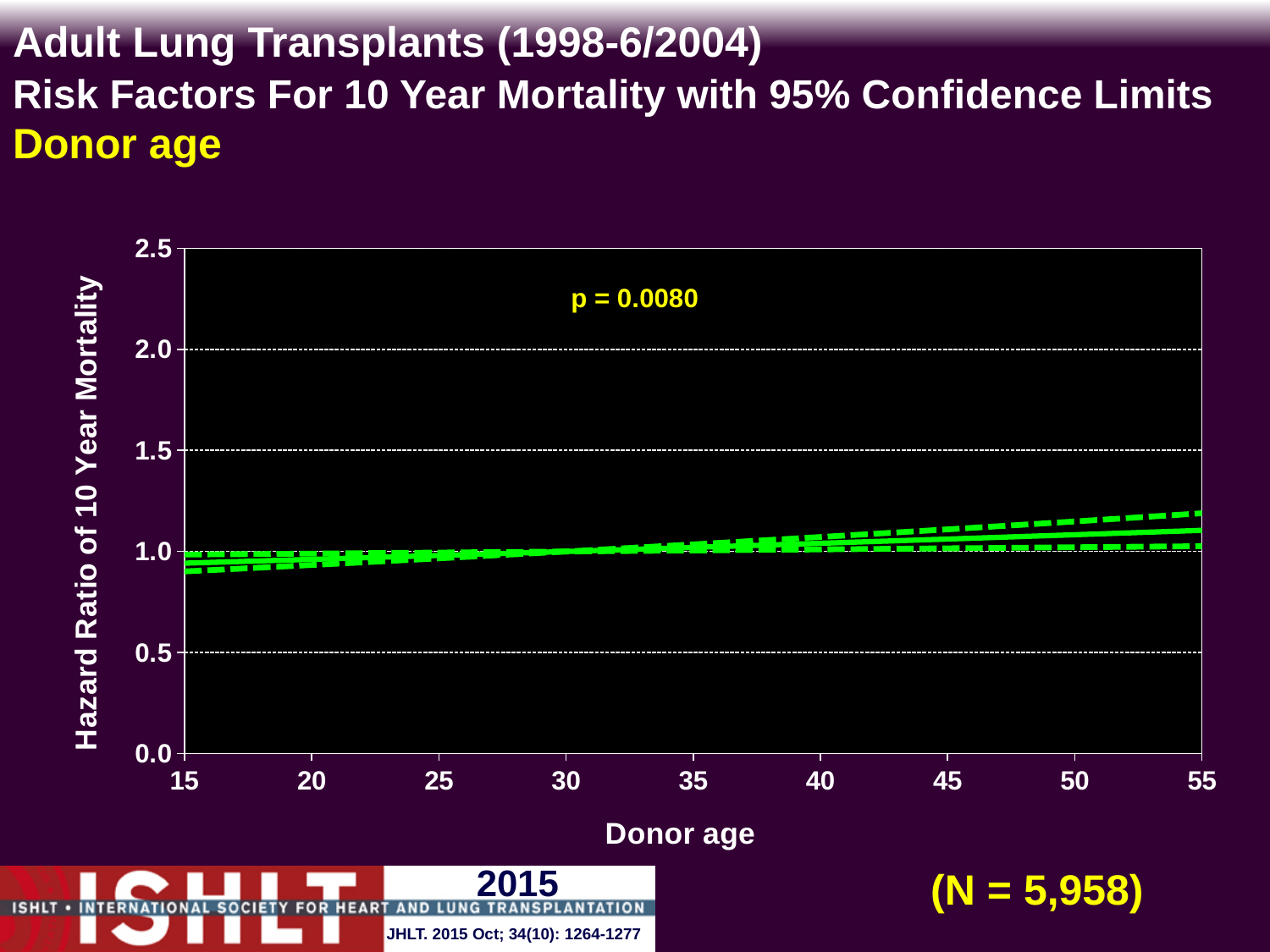
What p-value is printed on the chart? p = 0.0080 Is the hazard ratio at donor age 55 greater or less than 1.0? greater What sample size (N) is shown on the slide? N = 5,958 What kind of chart is shown on the slide? line chart Is the upper 95% confidence limit at donor age 55 greater or less than 1.5? less Which has the larger hazard ratio, donor age 15 or donor age 55? donor age 55 Is the hazard ratio at donor age 15 greater or less than 1.0? less Does the hazard ratio of 10 year mortality rise or fall as donor age increases from 15 to 55? rise